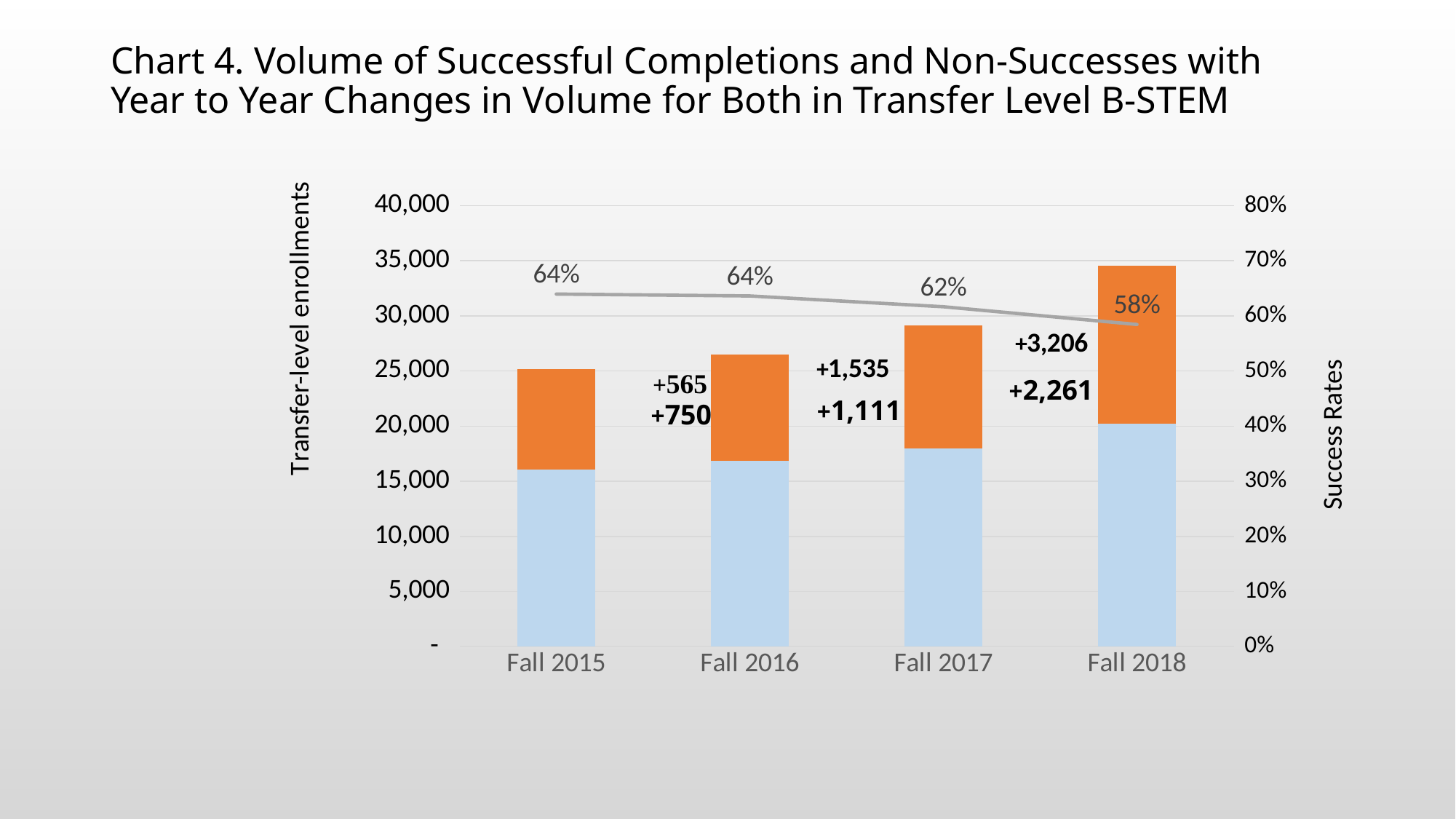
What success rate is shown for Fall 2015? 64% Is the total enrollment bar for Fall 2018 greater or less than 30,000? greater Which term has the lowest success rate? Fall 2018 What success rate is shown for Fall 2017? 62% What kind of chart is used to show the enrollment volumes? bar chart What success rate is shown for Fall 2018? 58% What is the label on the left vertical axis? Transfer-level enrollments Is the total enrollment bar for Fall 2015 greater or less than 30,000? less Does the success rate line rise or fall from Fall 2015 to Fall 2018? fall What two year-to-year change values are annotated beside the Fall 2016 bar? +565 and +750 How many terms are shown on the x axis? 4 Which term has a taller total enrollment bar, Fall 2016 or Fall 2017? Fall 2017